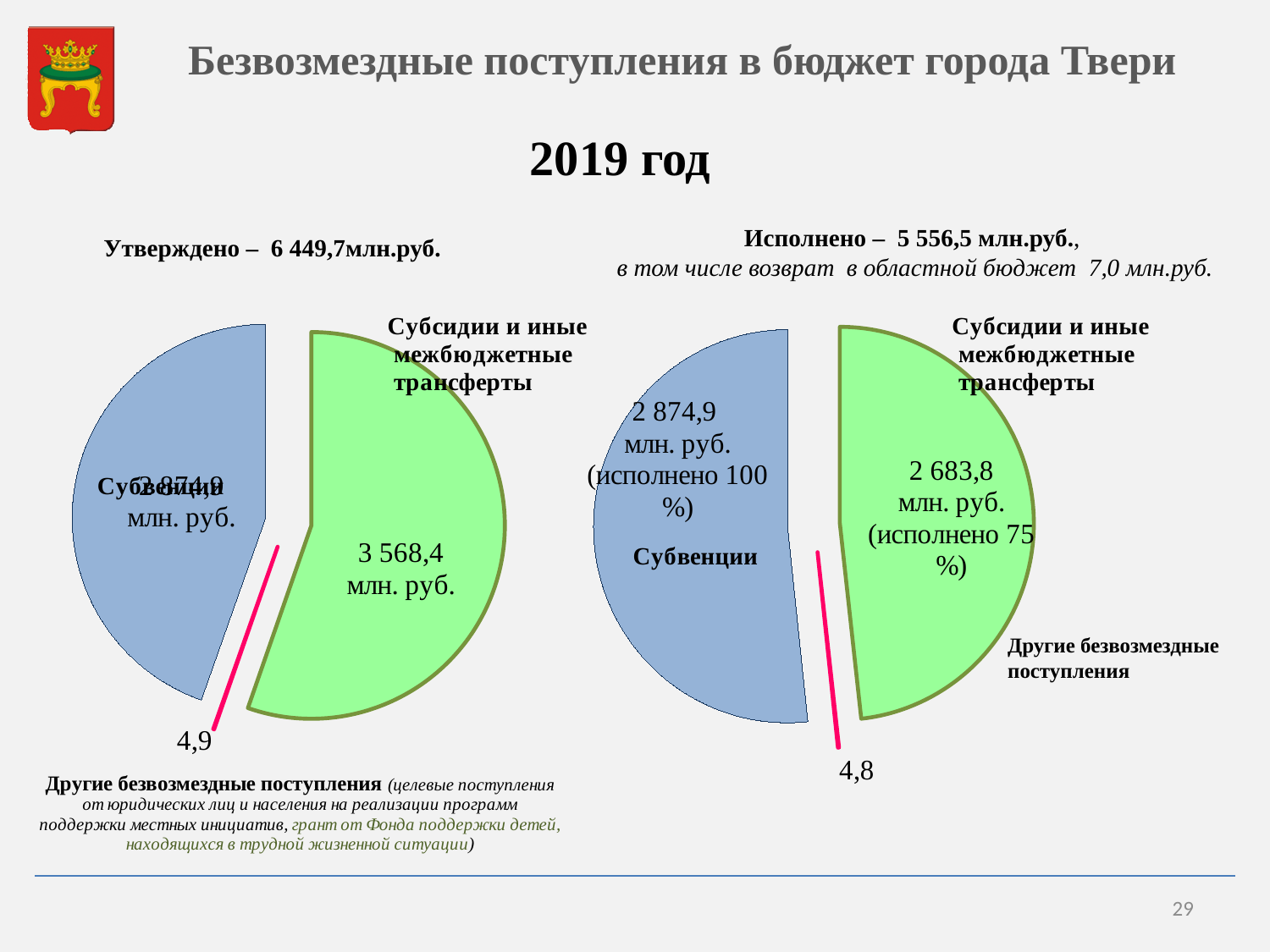
How many categories does each pie chart show? 3 In the right pie chart (Исполнено), what is the value for Субвенции? 2 874,9 млн. руб. In the left pie chart (Утверждено), what is the value for Субсидии и иные межбюджетные трансферты? 3 568,4 млн. руб. In the right pie chart (Исполнено), which category has the largest value? Субвенции What kind of charts are shown on the slide? Pie charts In the right pie chart (Исполнено), what is the value for Субсидии и иные межбюджетные трансферты? 2 683,8 млн. руб. In the left pie chart (Утверждено), what is the value for Другие безвозмездные поступления? 4,9 In the right pie chart (Исполнено), what is the difference between Субвенции and Субсидии и иные межбюджетные трансферты? 191,1 млн. руб. In the right pie chart (Исполнено), what is the value for Другие безвозмездные поступления? 4,8 What total is stated above the right pie chart (Исполнено)? 5 556,5 млн.руб. In the left pie chart (Утверждено), which category has the smallest value? Другие безвозмездные поступления In the right pie chart (Исполнено), what execution percentage is shown for Субсидии и иные межбюджетные трансферты? 75 %